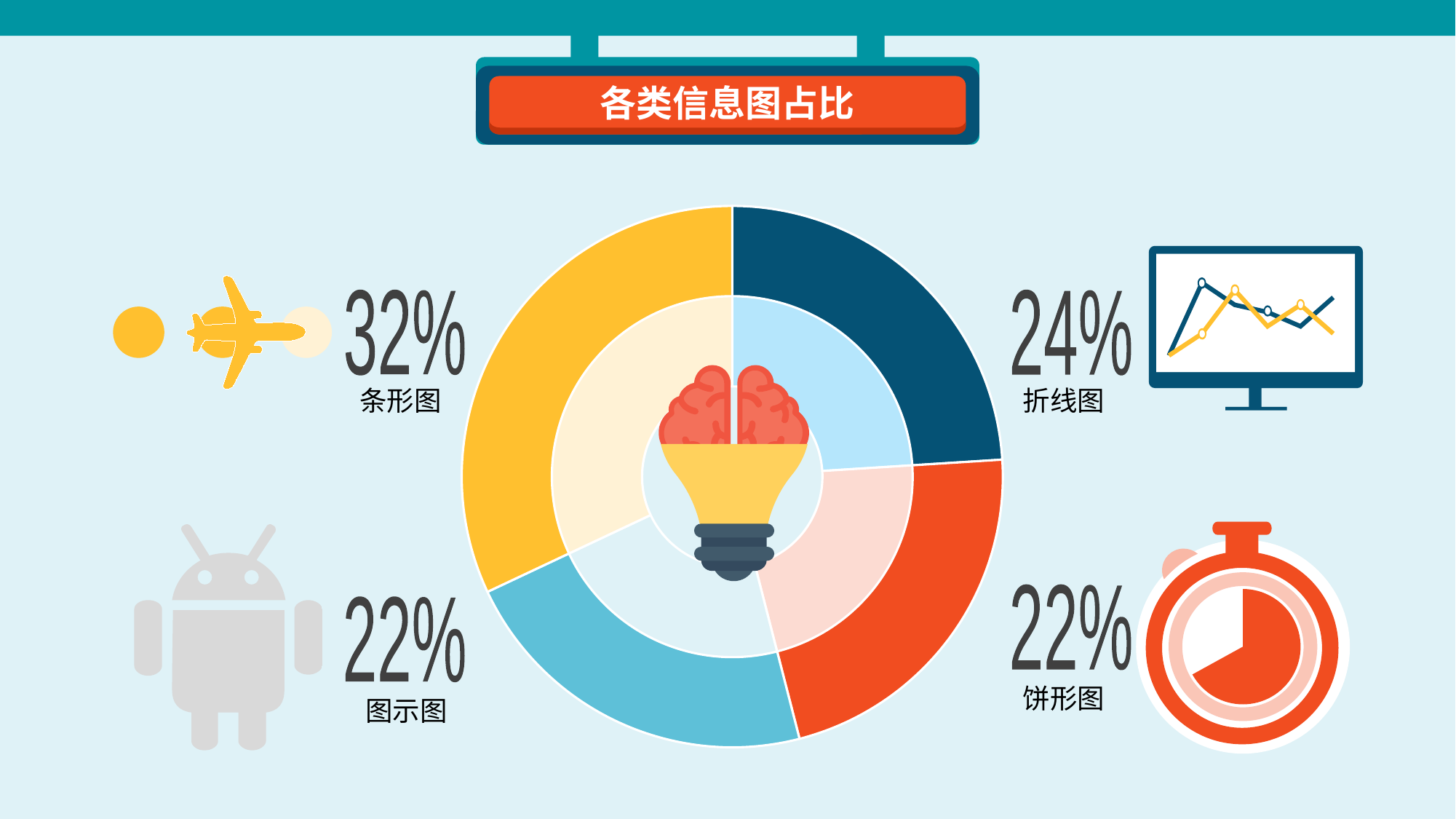
Which category has the largest share? 条形图 What kind of chart is shown on the slide? Donut (pie) chart What is the title of the chart? 各类信息图占比 Which is larger, the share of 条形图 or the share of 图示图? 条形图 What colour is the segment representing 条形图? Yellow What is the difference between the shares of 折线图 and 饼形图? 2% What is the value shown for 折线图? 24% What is the difference between the shares of 条形图 and 折线图? 8% What is the value shown for 图示图? 22% How many categories does the chart show? 4 What is the value shown for 饼形图? 22% What is the value shown for 条形图? 32%